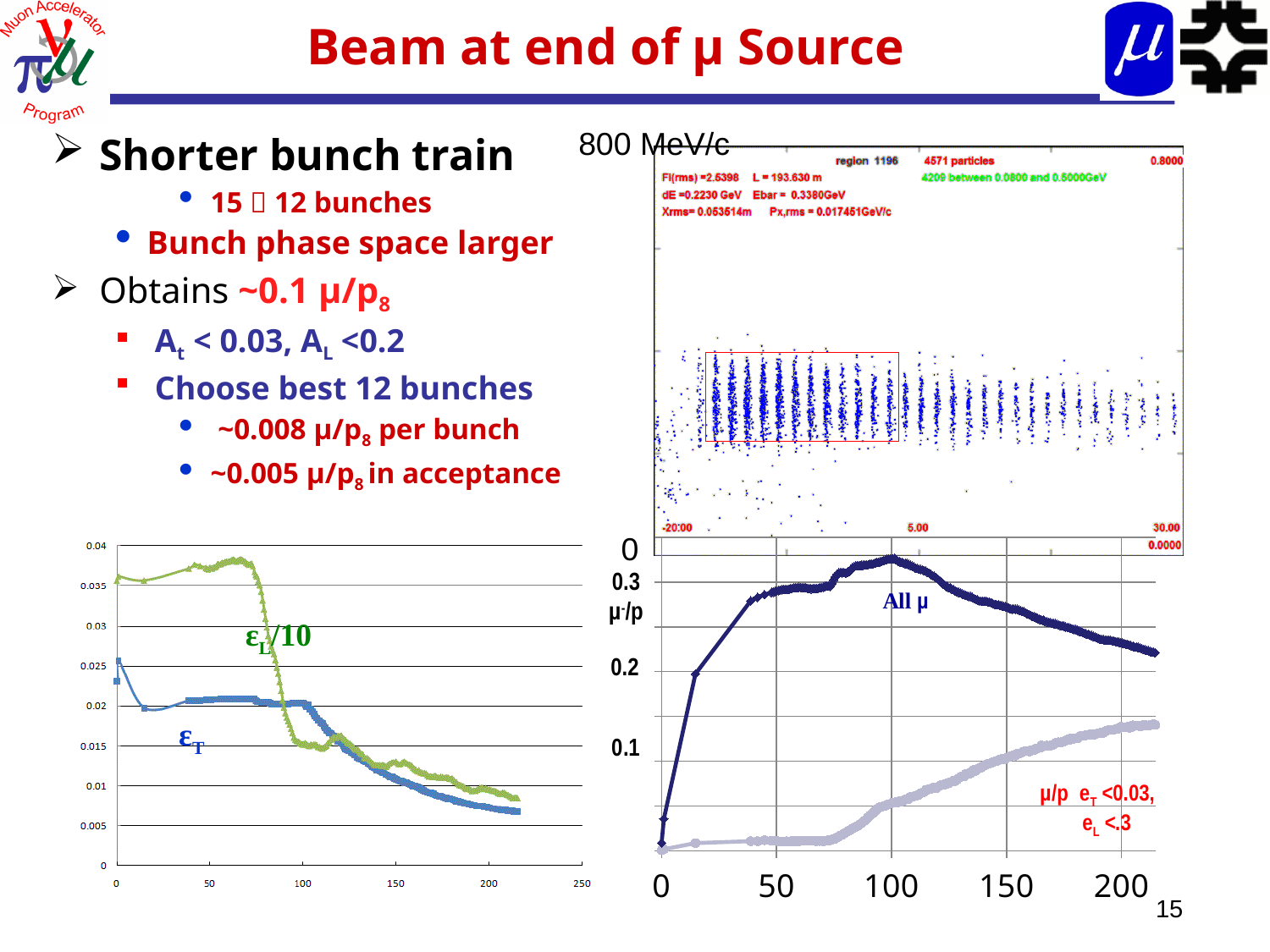
In the bottom-right chart, is the value of the μ/p (e_T <0.03, e_L <.3) curve at x = 50 greater or less than 0.1? less In the bottom-left chart, is the value of ε_L/10 at x = 50 greater or less than 0.03? greater In the bottom-left chart, do the ε_T values overall rise or fall as the x axis goes from 0 to 200? fall In the bottom-right chart, does the μ/p (e_T <0.03, e_L <.3) curve rise or fall as x goes from 100 to 200? rise In the bottom-left chart, is the value of ε_T at x = 200 greater or less than 0.01? less In the top-right scatter plot, how many particles are reported in the header text? 4571 particles In the bottom-left chart, which series has the larger value at x = 50, ε_L/10 or ε_T? ε_L/10 What kind of chart is the bottom-left chart showing ε_L/10 and ε_T? line chart In the bottom-right chart, which curve is higher at x = 150, All μ or μ/p with the acceptance cuts? All μ In the bottom-left chart, how many series are plotted? 2 What momentum label is printed above the top-right scatter plot? 800 MeV/c